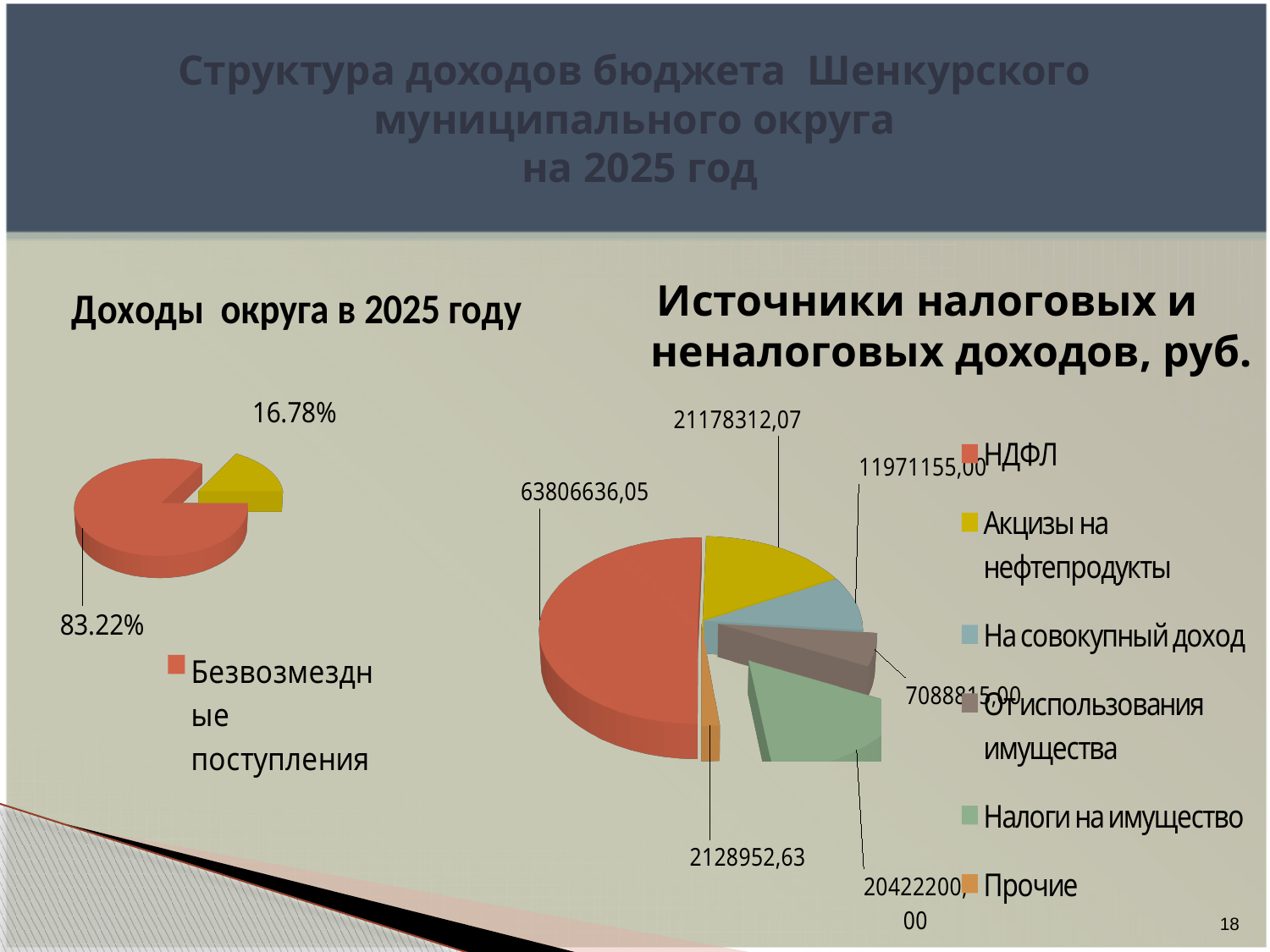
How many slices does the left chart "Доходы округа в 2025 году" have? 2 In the right chart "Источники налоговых и неналоговых доходов, руб.", what is the value for Налоги на имущество? 20422200,00 In the right chart "Источники налоговых и неналоговых доходов, руб.", what is the value for Прочие? 2128952,63 In the right chart "Источники налоговых и неналоговых доходов, руб.", which source has the largest value? НДФЛ In the right chart "Источники налоговых и неналоговых доходов, руб.", what is the value for Акцизы на нефтепродукты? 21178312,07 In the right chart "Источники налоговых и неналоговых доходов, руб.", what is the value for НДФЛ? 63806636,05 In the right chart "Источники налоговых и неналоговых доходов, руб.", what is the value for На совокупный доход? 11971155,00 What kind of chart is the left chart titled "Доходы округа в 2025 году"? pie chart In the right chart "Источники налоговых и неналоговых доходов, руб.", what is the difference between the values for НДФЛ and Акцизы на нефтепродукты? 42628323,98 How many entries does the legend of the right chart "Источники налоговых и неналоговых доходов, руб." list? 6 In the left chart "Доходы округа в 2025 году", what share is shown for Безвозмездные поступления? 83.22% In the right chart "Источники налоговых и неналоговых доходов, руб.", which source has the smallest value? Прочие